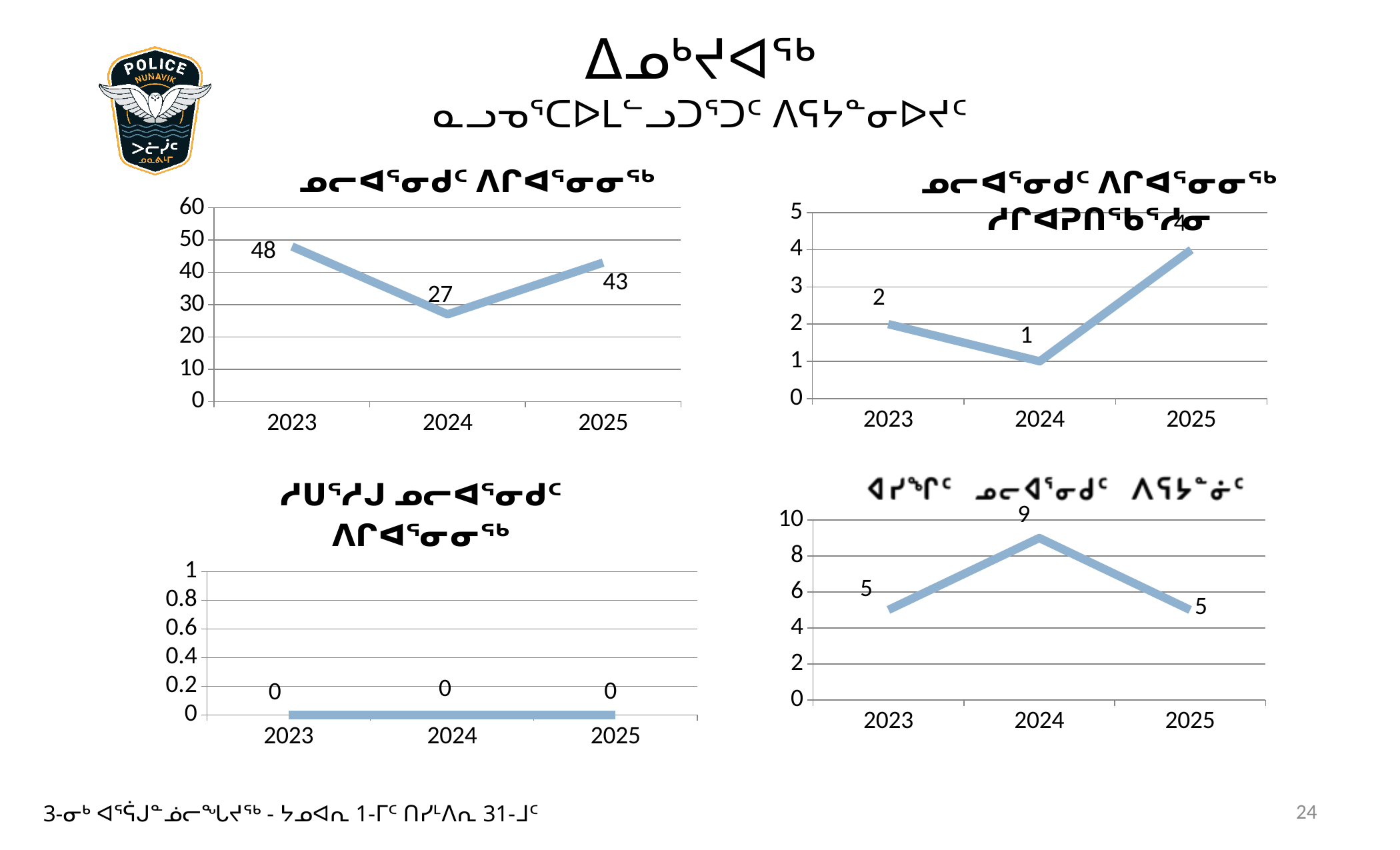
In the top-right chart, which year has the highest value? 2025 In the top-left chart, what is the value for 2024? 27 In the top-left chart, what is the difference between the 2023 and 2025 values? 5 In the top-left chart, what is the value for 2023? 48 What type of chart is the bottom-right chart? line chart In the top-right chart, what is the value for 2024? 1 In the bottom-right chart, what is the value for 2024? 9 In the top-left chart, which year has the lowest value? 2024 In the bottom-left chart, what is the value for 2025? 0 In the bottom-right chart, what is the difference between the 2024 and 2025 values? 4 How many charts are shown on the slide? 4 In the top-right chart, is the value for 2023 larger or smaller than the value for 2025? smaller